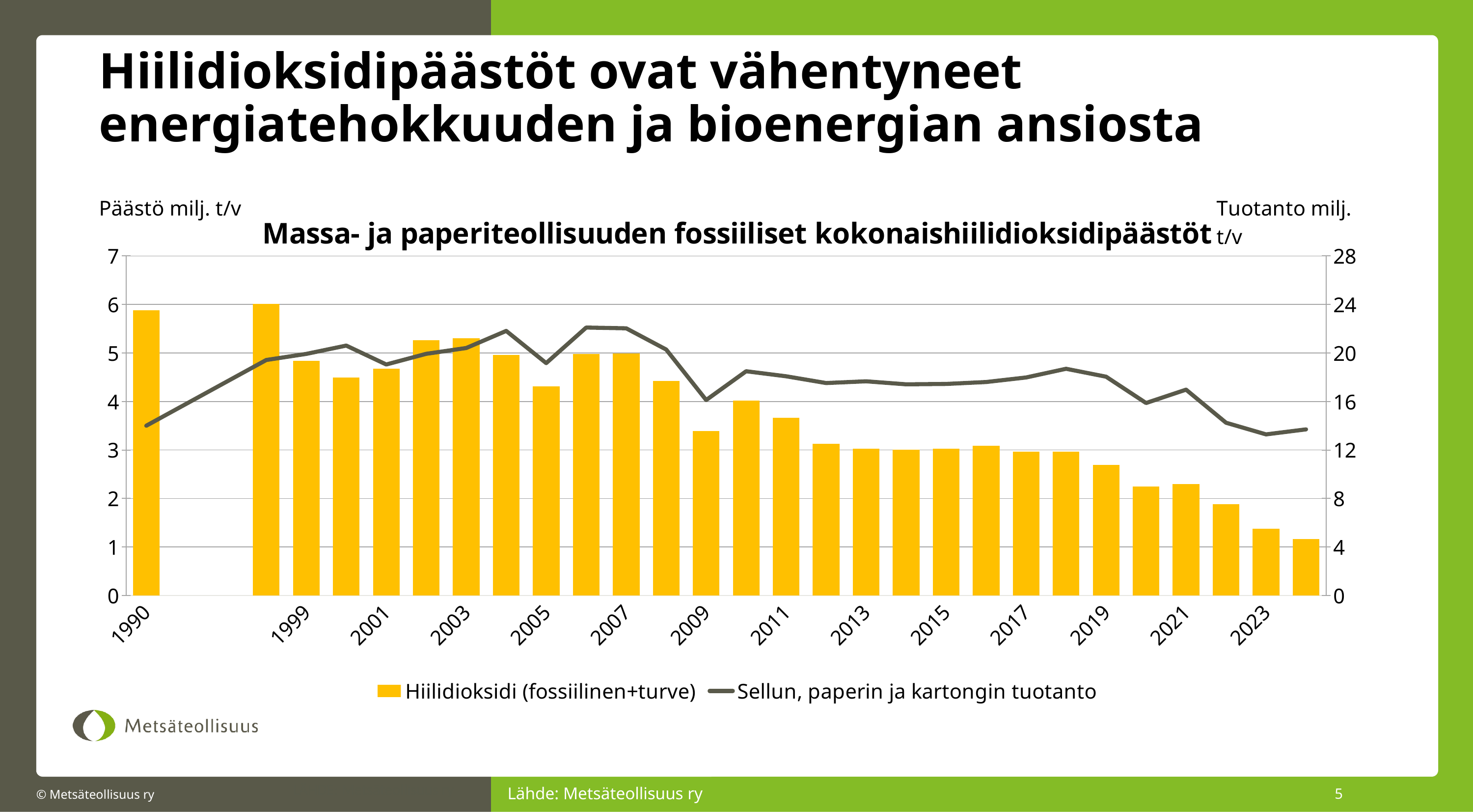
What kind of chart is used to show the Hiilidioksidi (fossiilinen+turve) series? Bar chart How many series does the chart legend list? 2 What is the title of the chart? Massa- ja paperiteollisuuden fossiiliset kokonaishiilidioksidipäästöt Is the Hiilidioksidi (fossiilinen+turve) value for 2003 greater or less than 5? greater Which year has the larger Hiilidioksidi (fossiilinen+turve) value, 1990 or 2023? 1990 Is the Hiilidioksidi (fossiilinen+turve) value for 2009 greater or less than 4? less Is the Sellun, paperin ja kartongin tuotanto value for 2007 greater or less than 20 on the right axis? greater Which series is drawn as a line rather than bars? Sellun, paperin ja kartongin tuotanto Do the Hiilidioksidi (fossiilinen+turve) bars generally rise or fall from 2007 to 2023? Fall